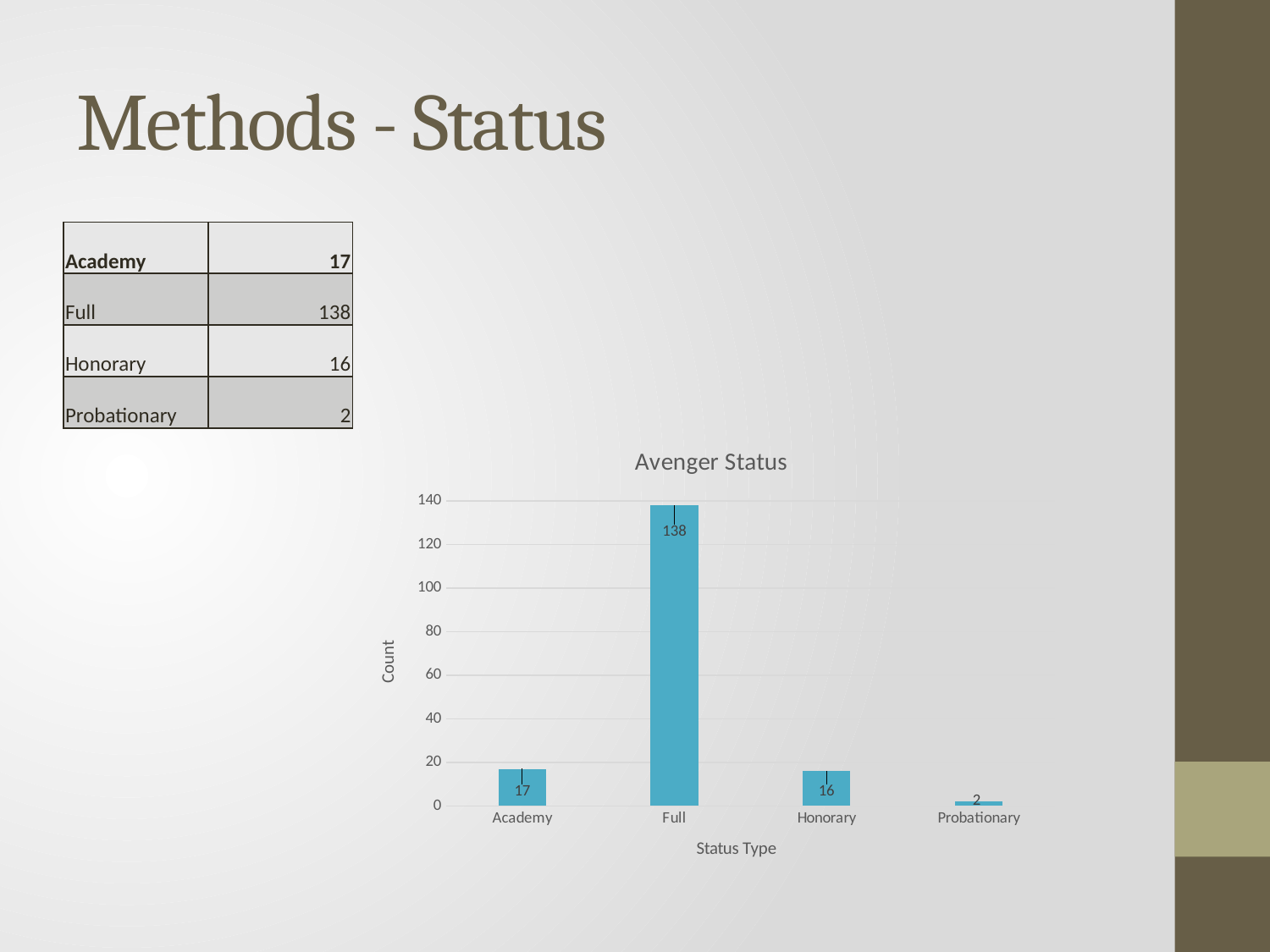
What is the value for Honorary in the Avenger Status chart? 16 How many status types are shown in the Avenger Status chart? 4 Which is larger in the Avenger Status chart, Academy or Probationary? Academy Which status type has the lowest count in the Avenger Status chart? Probationary What is the label of the x axis in the Avenger Status chart? Status Type What is the value for Probationary in the Avenger Status chart? 2 What is the value for Full in the Avenger Status chart? 138 What kind of chart is the Avenger Status chart? bar chart Is the value for Full greater or less than 120 in the Avenger Status chart? greater What is the value for Academy in the Avenger Status chart? 17 Which status type has the highest count in the Avenger Status chart? Full What is the difference between the Full and Academy values in the Avenger Status chart? 121